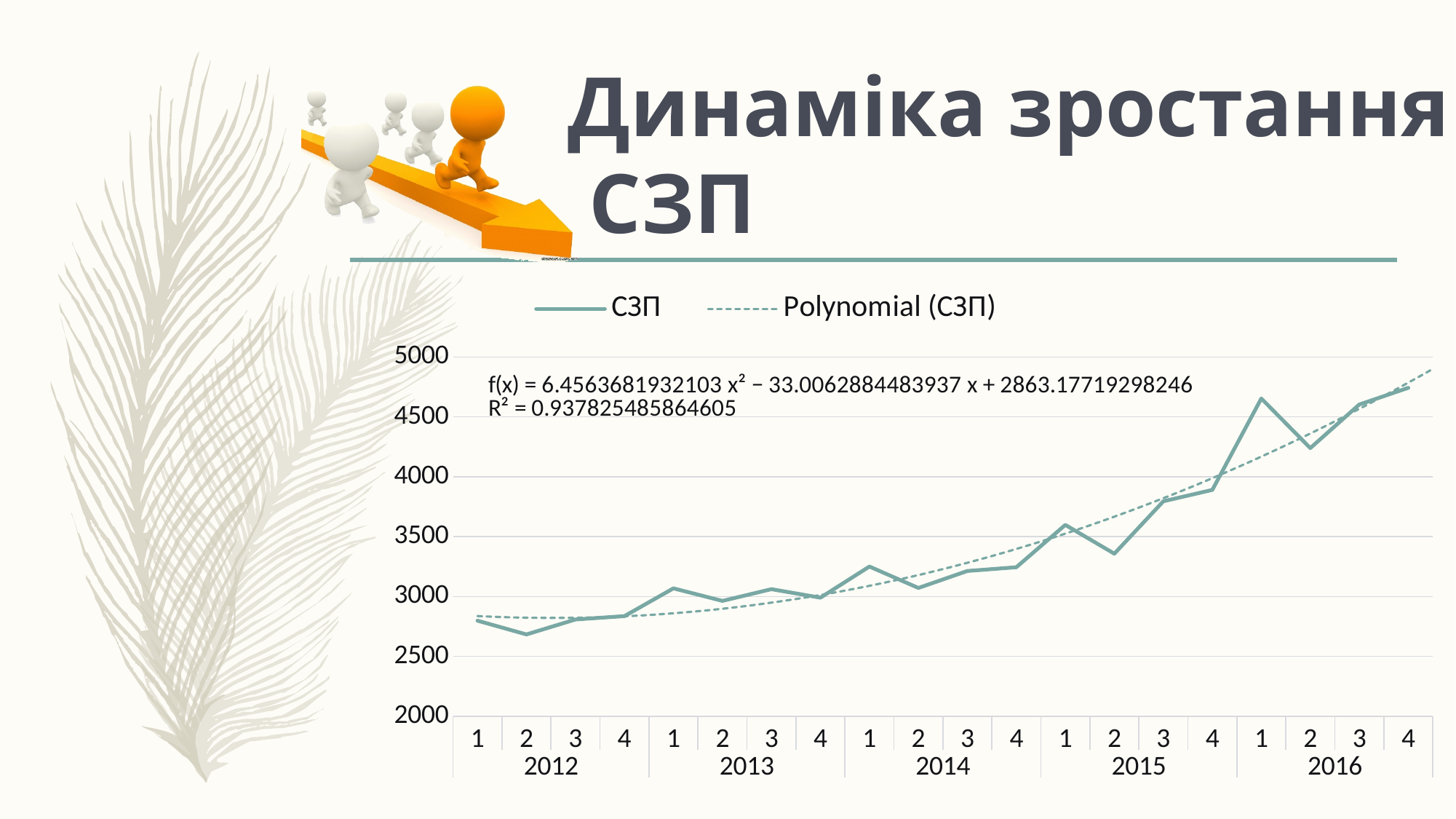
Is the СЗП value for quarter 4 of 2015 greater or less than 4000? less How many entries does the chart legend list? 2 Is the СЗП value for quarter 1 of 2015 greater or less than 3500? greater Do the СЗП values generally rise or fall from 2012 to 2016? rise Which is larger, the СЗП value for quarter 1 of 2015 or quarter 2 of 2015? quarter 1 of 2015 Is the СЗП value for quarter 2 of 2012 greater or less than 3000? less How many data points are plotted along the x axis of the chart? 20 What is the name of the dashed series in the chart legend? Polynomial (СЗП) Which quarter has the lowest СЗП value on the chart? 2012 quarter 2 What kind of chart is shown on the slide? line chart What R² value is printed on the chart for the polynomial trendline? 0.937825485864605